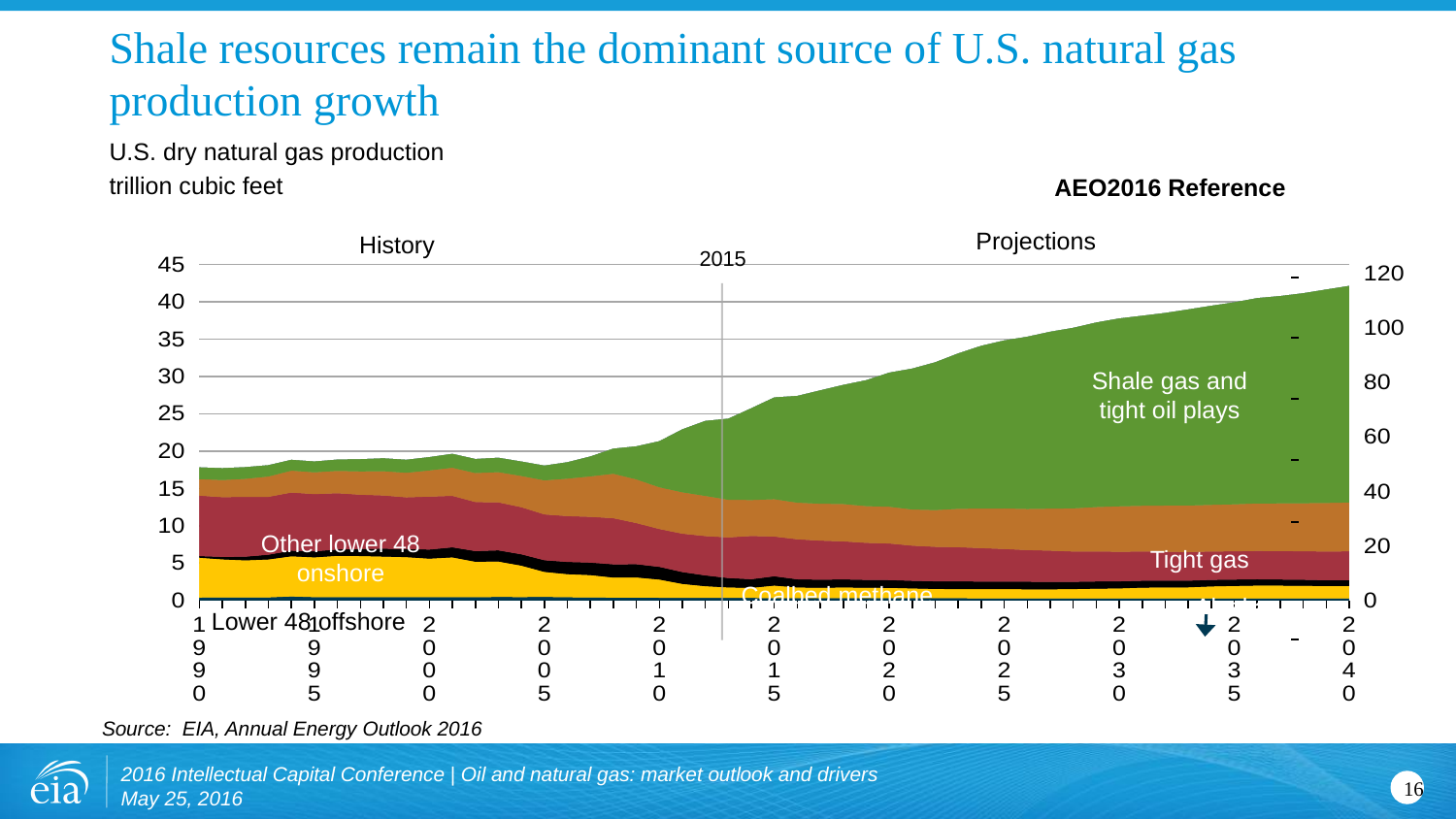
Which is larger: total production in 2040 or total production in 2000? 2040 Which source of natural gas production accounts for the largest share of the total in 2040? Shale gas and tight oil plays What unit is U.S. dry natural gas production measured in on this chart? trillion cubic feet Is total U.S. dry natural gas production in 2040 greater or less than 40 trillion cubic feet? greater Is total U.S. dry natural gas production in 1990 greater or less than 20 trillion cubic feet? less What is the highest value shown on the left vertical axis? 45 Which year separates the History and Projections sections of the chart? 2015 How many production sources are labeled on the chart? 5 Is total U.S. dry natural gas production in 2015 greater or less than 25 trillion cubic feet? greater Does total U.S. dry natural gas production rise or fall over the projection period from 2015 to 2040? rise What kind of chart is shown on the slide? stacked area chart How many year labels appear along the x axis? 11